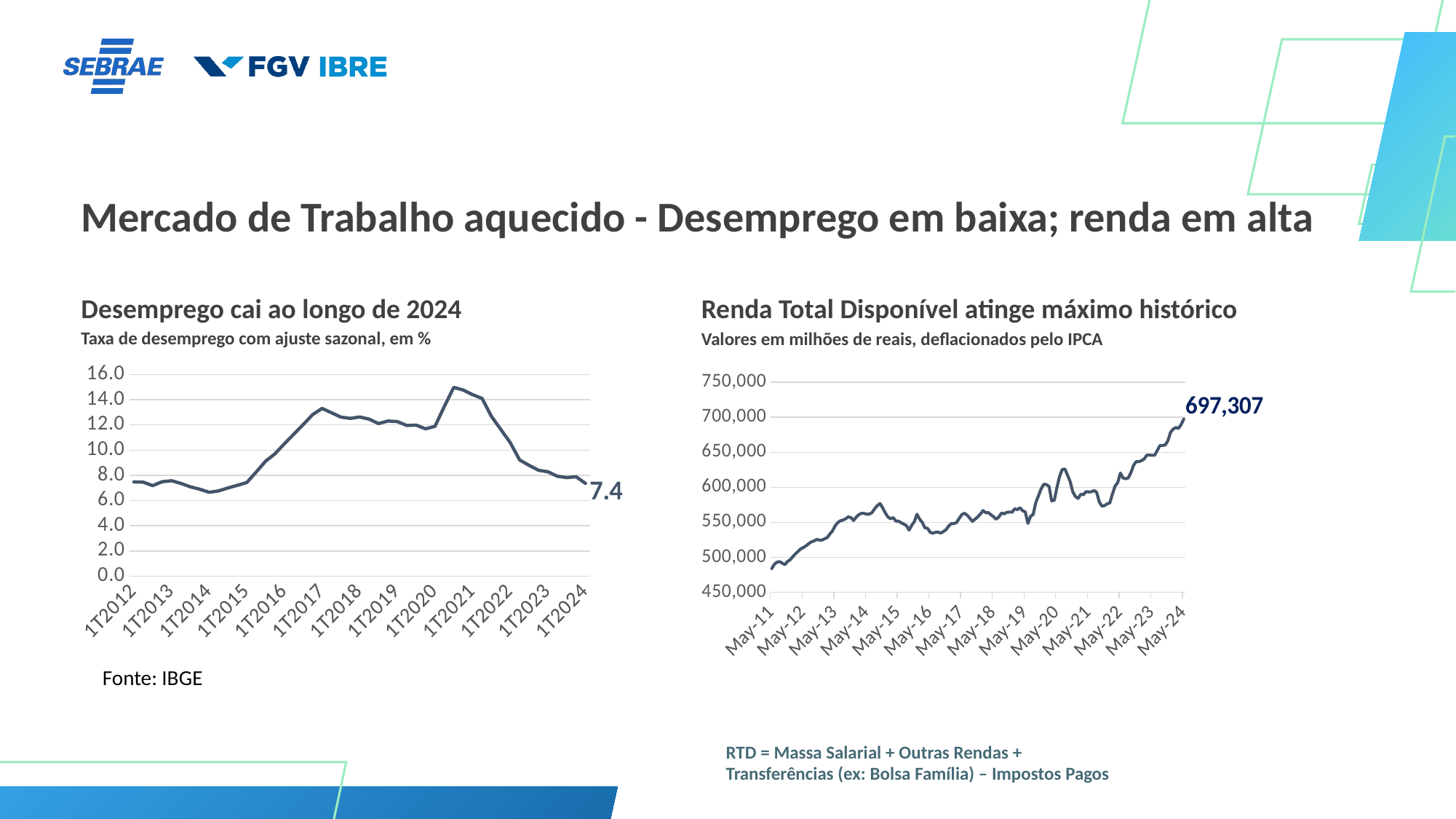
In the left chart 'Desemprego cai ao longo de 2024', do the values rise or fall between 1T2021 and 1T2024? fall In the right chart 'Renda Total Disponível atinge máximo histórico', is the value at May-11 greater or less than 500,000? less In the right chart 'Renda Total Disponível atinge máximo histórico', at which x-axis label does the line reach its highest value? May-24 In the right chart 'Renda Total Disponível atinge máximo histórico', do the values overall rise or fall from May-11 to May-24? rise What kind of chart is the left chart titled 'Desemprego cai ao longo de 2024'? line chart What kind of chart is the right chart titled 'Renda Total Disponível atinge máximo histórico'? line chart In the left chart 'Desemprego cai ao longo de 2024', is the value at 1T2017 greater or less than 12.0? greater In the left chart 'Desemprego cai ao longo de 2024', which is larger: the value at 1T2021 or the value at 1T2024? 1T2021 In the left chart 'Desemprego cai ao longo de 2024', is the value at 1T2014 greater or less than 8.0? less In the right chart 'Renda Total Disponível atinge máximo histórico', what is the value labelled at the last data point (May-24)? 697,307 In the left chart 'Desemprego cai ao longo de 2024', what is the value shown at the last data point (1T2024)? 7.4